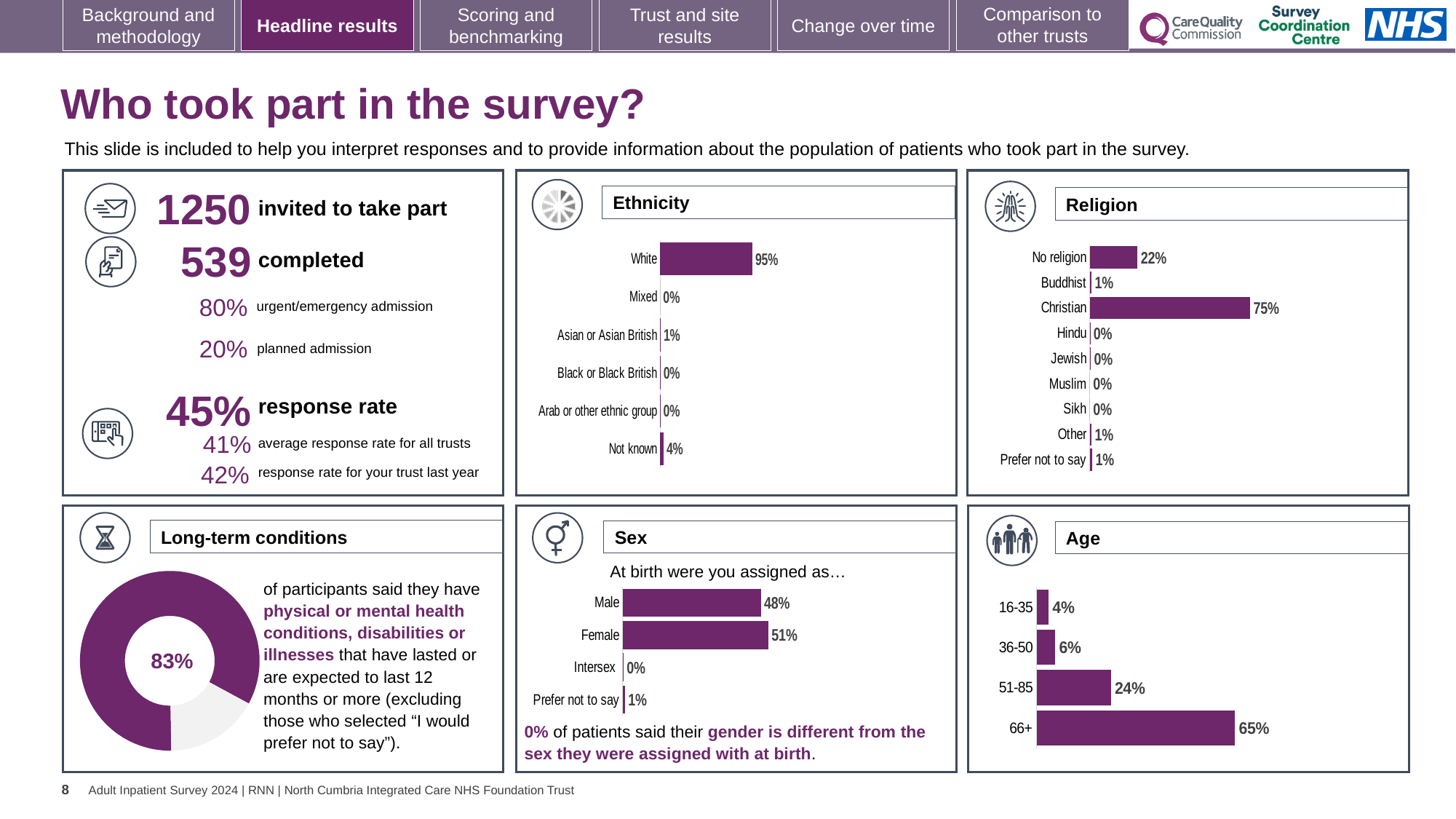
In the Age chart, which age group has the lowest value? 16-35 In the Ethnicity chart, what percentage of respondents are White? 95% In the Age chart, what is the value for 51-85? 24% In the Ethnicity chart, how many categories are shown? 6 In the Religion chart, how many categories are shown? 9 In the Sex chart, what percentage of respondents answered Prefer not to say? 1% In the Religion chart, what is the difference between the Christian and No religion values? 53% What kind of chart is used in the Long-term conditions panel? Doughnut chart In the Sex chart, which is larger, Male or Female? Female In the Religion chart, what percentage of respondents are Christian? 75% In the Ethnicity chart, which category has the highest value? White In the Age chart, do the values rise or fall as the age groups increase from 16-35 to 66+? rise